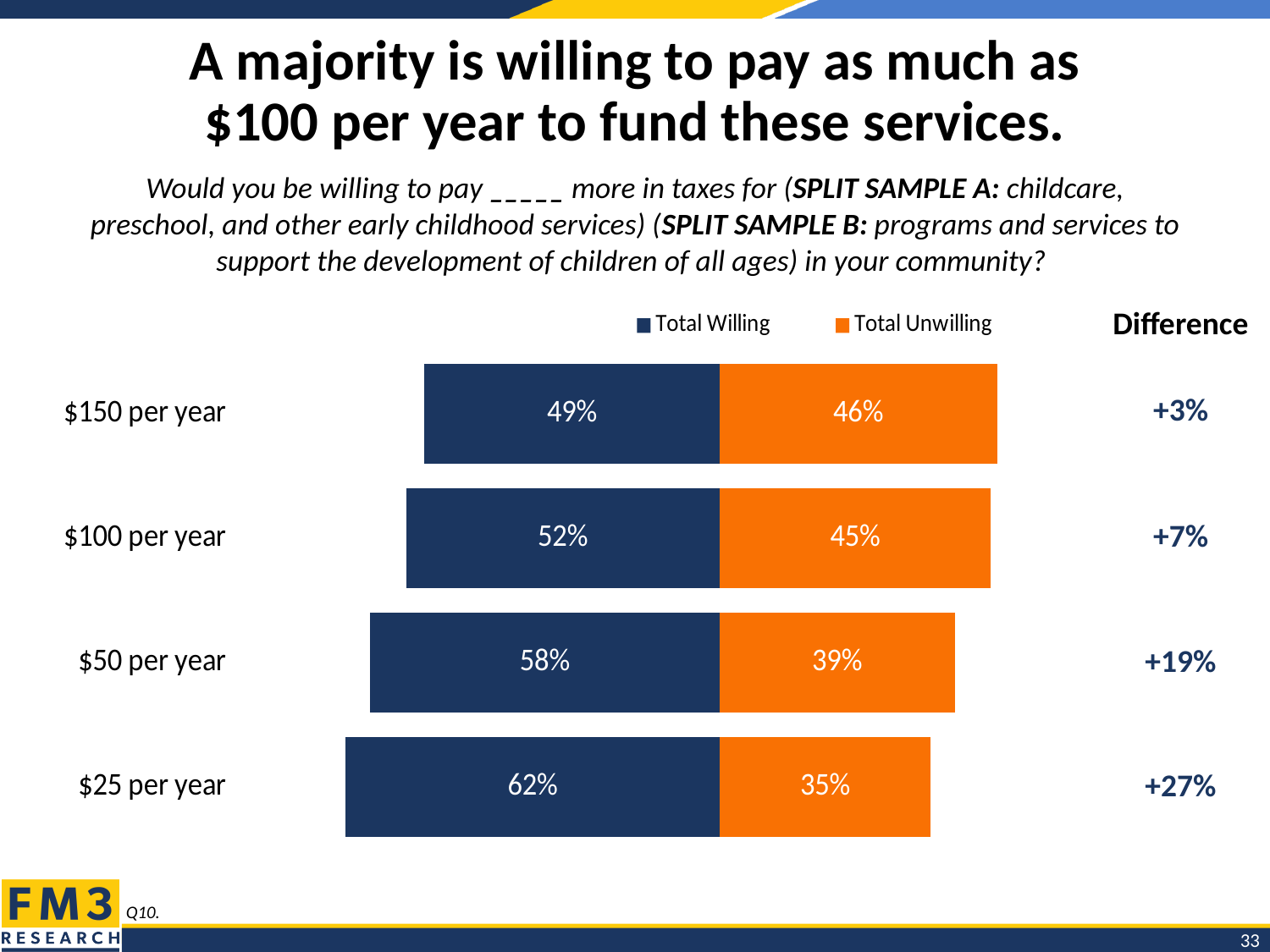
What is the Total Willing value for $25 per year? 62% What percentage is Total Willing for $100 per year? 52% How many series does the legend list? 2 What kind of chart is shown on the slide? Stacked bar chart Which colour represents Total Unwilling in the chart? Orange What percentage is Total Unwilling for $150 per year? 46% What is the difference between Total Willing and Total Unwilling for $50 per year? +19% How many amounts per year are shown in the chart? 4 What is the combined total of Total Willing and Total Unwilling for $100 per year? 97% Which amount per year has the lowest Total Unwilling percentage? $25 per year Which is larger for $150 per year, Total Willing or Total Unwilling? Total Willing Which amount per year has the highest Total Willing percentage? $25 per year